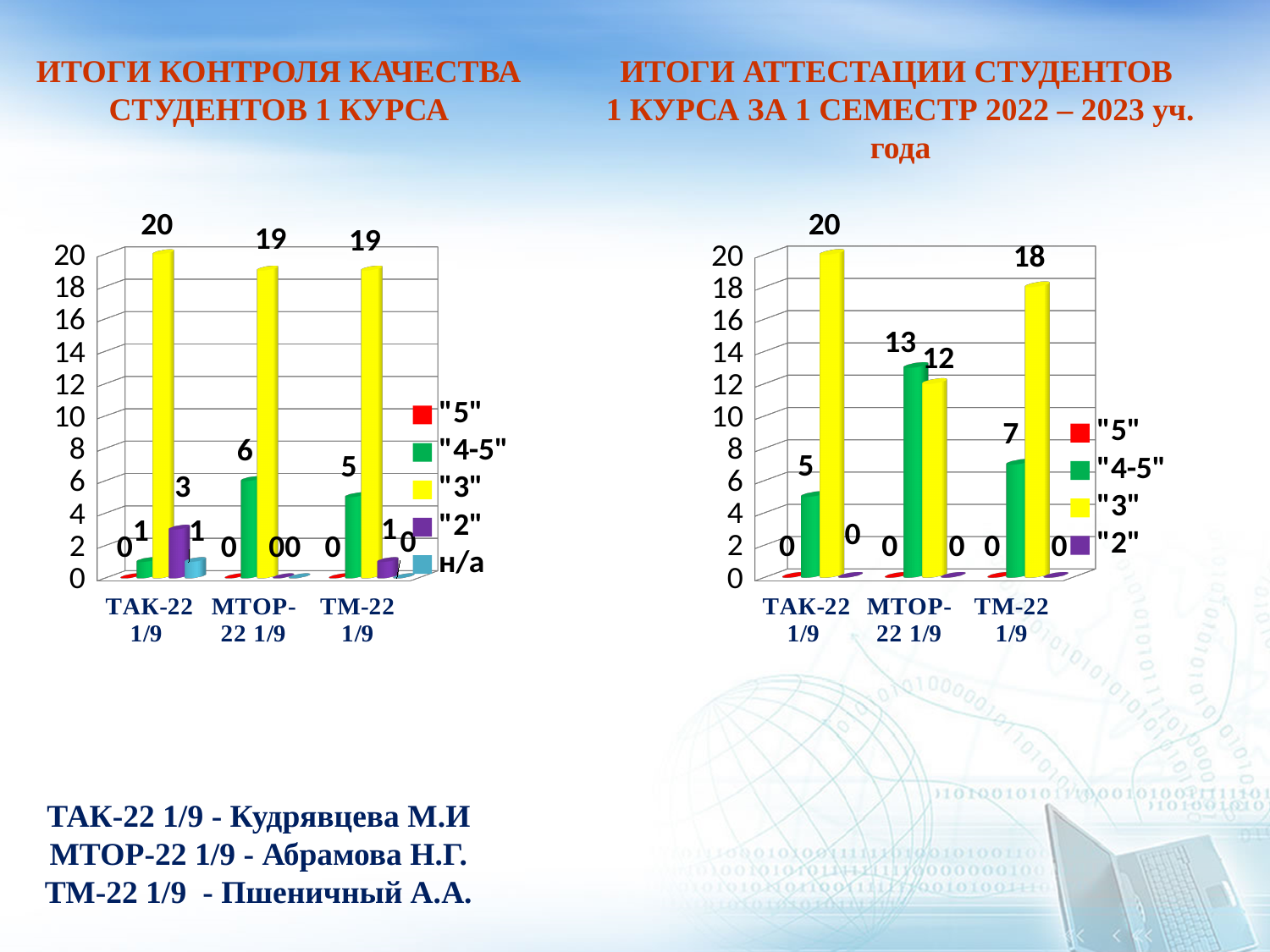
In the left chart (ИТОГИ КОНТРОЛЯ КАЧЕСТВА СТУДЕНТОВ 1 КУРСА), what is the value of the "3" series for ТАК-22 1/9? 20 In the right chart (ИТОГИ АТТЕСТАЦИИ СТУДЕНТОВ 1 КУРСА), how many groups are shown on the x axis? 3 In the right chart (ИТОГИ АТТЕСТАЦИИ СТУДЕНТОВ 1 КУРСА), which group has the lowest value for the "3" series? МТОР-22 1/9 In the right chart (ИТОГИ АТТЕСТАЦИИ СТУДЕНТОВ 1 КУРСА), what is the value of the "3" series for ТМ-22 1/9? 18 In the right chart (ИТОГИ АТТЕСТАЦИИ СТУДЕНТОВ 1 КУРСА), what is the value of the "4-5" series for МТОР-22 1/9? 13 In the right chart (ИТОГИ АТТЕСТАЦИИ СТУДЕНТОВ 1 КУРСА), which is larger for МТОР-22 1/9: the "4-5" value or the "3" value? "4-5" In the left chart (ИТОГИ КОНТРОЛЯ КАЧЕСТВА СТУДЕНТОВ 1 КУРСА), what is the value of the "4-5" series for МТОР-22 1/9? 6 In the left chart (ИТОГИ КОНТРОЛЯ КАЧЕСТВА СТУДЕНТОВ 1 КУРСА), what is the difference between the "3" values for ТАК-22 1/9 and ТМ-22 1/9? 1 In the left chart (ИТОГИ КОНТРОЛЯ КАЧЕСТВА СТУДЕНТОВ 1 КУРСА), how many series does the legend list? 5 What kind of chart is the right chart (ИТОГИ АТТЕСТАЦИИ СТУДЕНТОВ 1 КУРСА)? Bar chart In the left chart (ИТОГИ КОНТРОЛЯ КАЧЕСТВА СТУДЕНТОВ 1 КУРСА), which group has the highest value for the "4-5" series? МТОР-22 1/9 In the left chart (ИТОГИ КОНТРОЛЯ КАЧЕСТВА СТУДЕНТОВ 1 КУРСА), what is the value of the "2" series for ТАК-22 1/9? 3